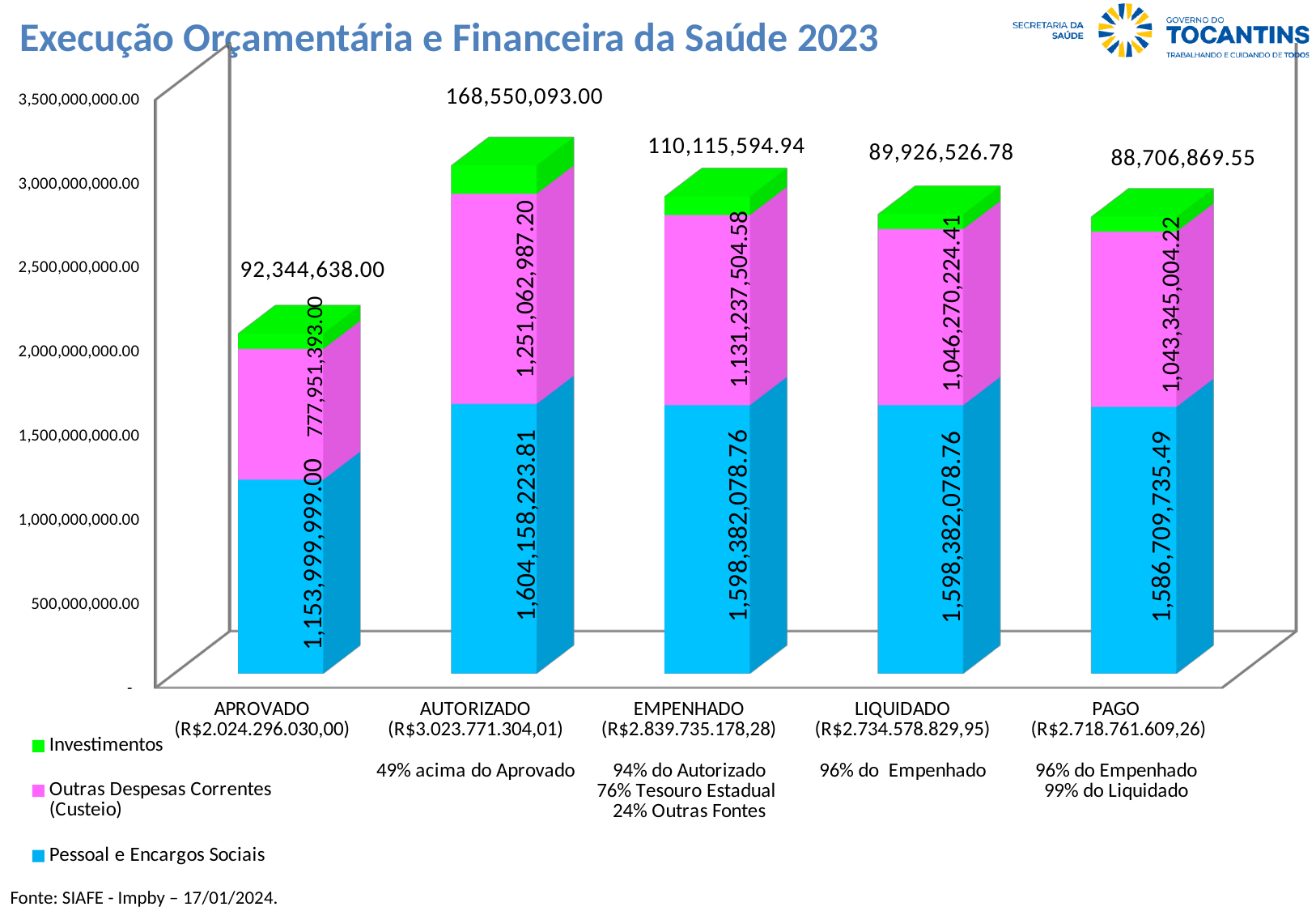
What is the value of Outras Despesas Correntes (Custeio) for EMPENHADO? 1,131,237,504.58 What is the total of the stacked bar for EMPENHADO? R$2.839.735.178,28 What is the difference between the Investimentos values for AUTORIZADO and APROVADO? 76,205,455.00 What is the value of Investimentos for AUTORIZADO? 168,550,093.00 How many categories are shown on the x axis? 5 What kind of chart is shown on the slide? Stacked bar chart What is the value of Pessoal e Encargos Sociais for PAGO? 1,586,709,735.49 Which category has the highest value for Investimentos? AUTORIZADO How many series does the legend list? 3 Which is larger, the Outras Despesas Correntes (Custeio) value for APROVADO or for LIQUIDADO? LIQUIDADO Is the total for the APROVADO bar greater or less than 2,500,000,000.00? less Which category has the lowest value for Pessoal e Encargos Sociais? APROVADO